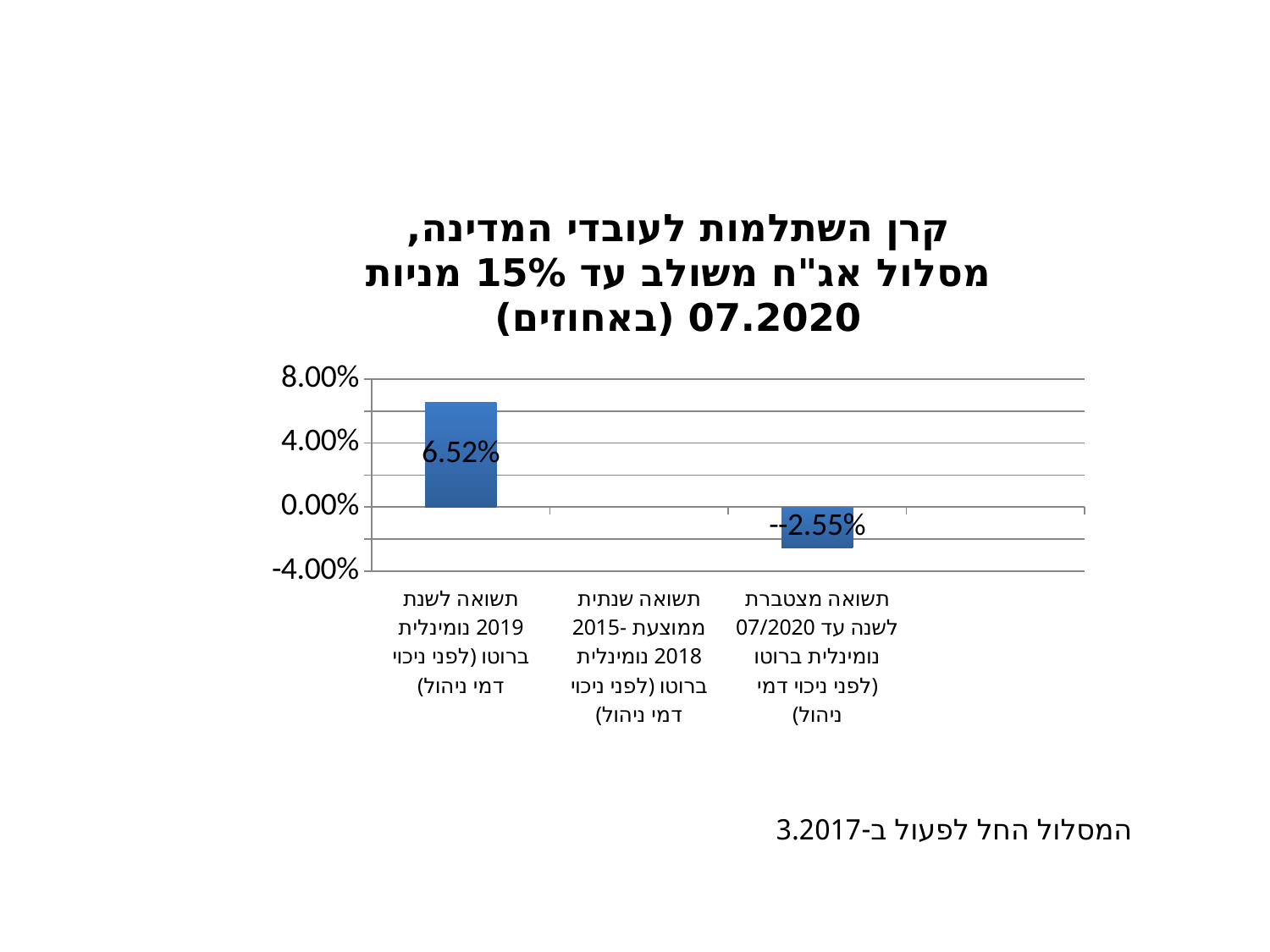
How many categories are labelled on the x axis? 3 What is the value for the category "תשואה מצטברת לשנה עד 07/2020 נומינלית ברוטו (לפני ניכוי דמי ניהול)"? -2.55% What is the value for the category "תשואה לשנת 2019 נומינלית ברוטו (לפני ניכוי דמי ניהול)"? 6.52% Which category has the lowest plotted value? תשואה מצטברת לשנה עד 07/2020 נומינלית ברוטו (לפני ניכוי דמי ניהול) What kind of chart is shown on the slide? Bar chart Which category has the highest value? תשואה לשנת 2019 נומינלית ברוטו (לפני ניכוי דמי ניהול) Which is larger: the value for "תשואה לשנת 2019" or the value for "תשואה מצטברת לשנה עד 07/2020"? תשואה לשנת 2019 What is the difference between the value for 2019 (6.52%) and the value for the period up to 07/2020 (-2.55%)? 9.07% Is the value for "תשואה מצטברת לשנה עד 07/2020" greater or less than 0.00%? less What is the title of the chart? קרן השתלמות לעובדי המדינה, מסלול אג"ח משולב עד 15% מניות 07.2020 (באחוזים) Is the value for "תשואה לשנת 2019 נומינלית ברוטו" greater or less than 4.00%? greater What is the highest value shown on the y axis? 8.00%